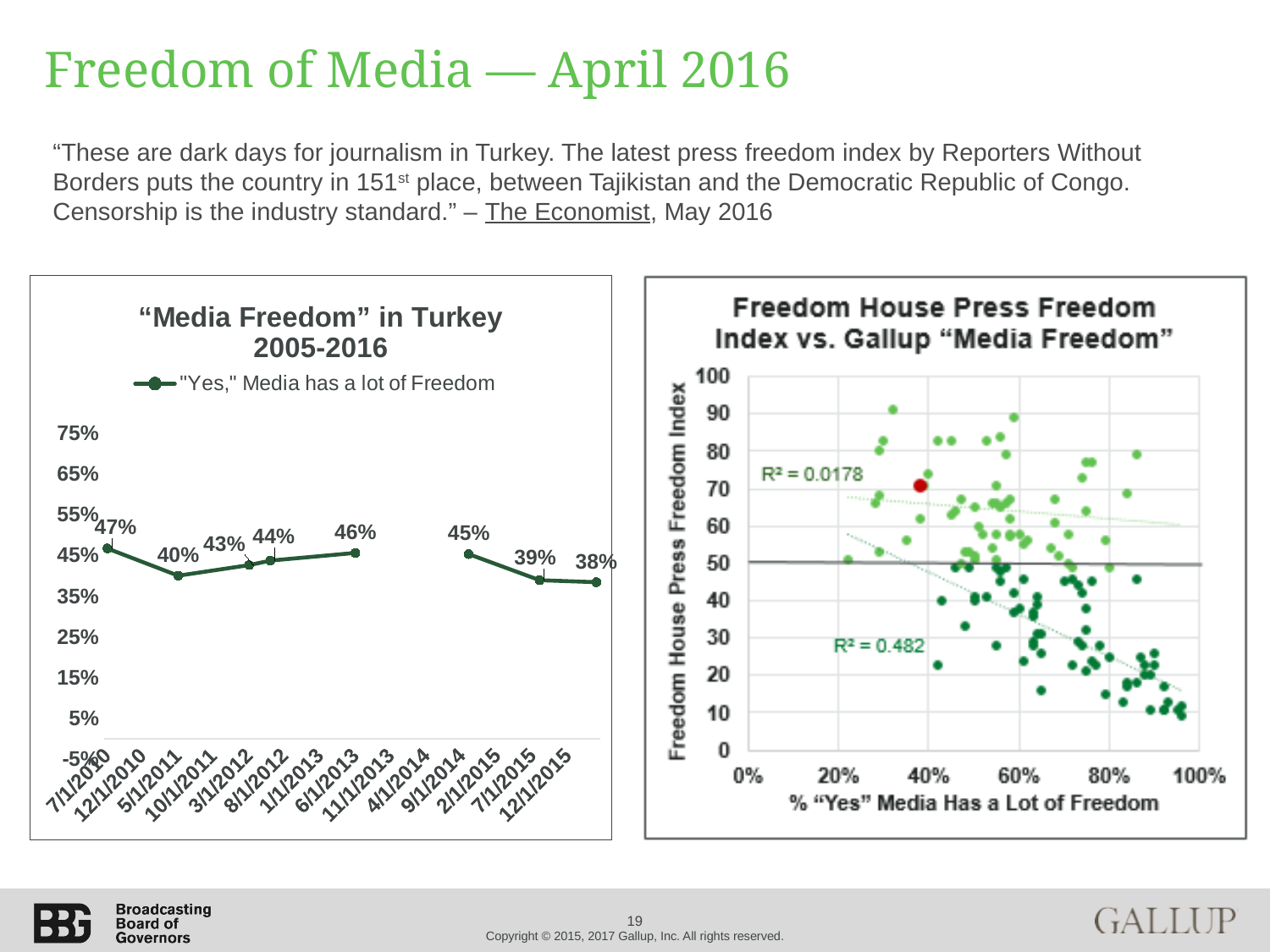
In the "Media Freedom" in Turkey chart, what is the highest value shown? 47% What type of chart is the "Media Freedom" in Turkey 2005-2016 chart on the left? line chart What type of chart is the "Freedom House Press Freedom Index vs. Gallup 'Media Freedom'" chart on the right? scatter plot In the "Media Freedom" in Turkey chart, what is the lowest value shown? 38% In the "Media Freedom" in Turkey chart, how many data points are labelled on the line? 8 In the "Media Freedom" in Turkey chart, what is the value of the first data point on the line? 47% In the "Media Freedom" in Turkey chart, is the first value (47%) or the last value (38%) larger? 47% How many series does the legend of the "Media Freedom" in Turkey chart list? 1 In the "Media Freedom" in Turkey chart, what is the difference between the highest value (47%) and the lowest value (38%)? 9 percentage points In the "Media Freedom" in Turkey chart, do the values overall rise or fall from the first point to the last point? fall In the "Freedom House Press Freedom Index vs. Gallup 'Media Freedom'" chart, what is the R² value shown for the lower trend line? R² = 0.482 In the "Media Freedom" in Turkey chart, what is the value of the last data point on the line? 38%